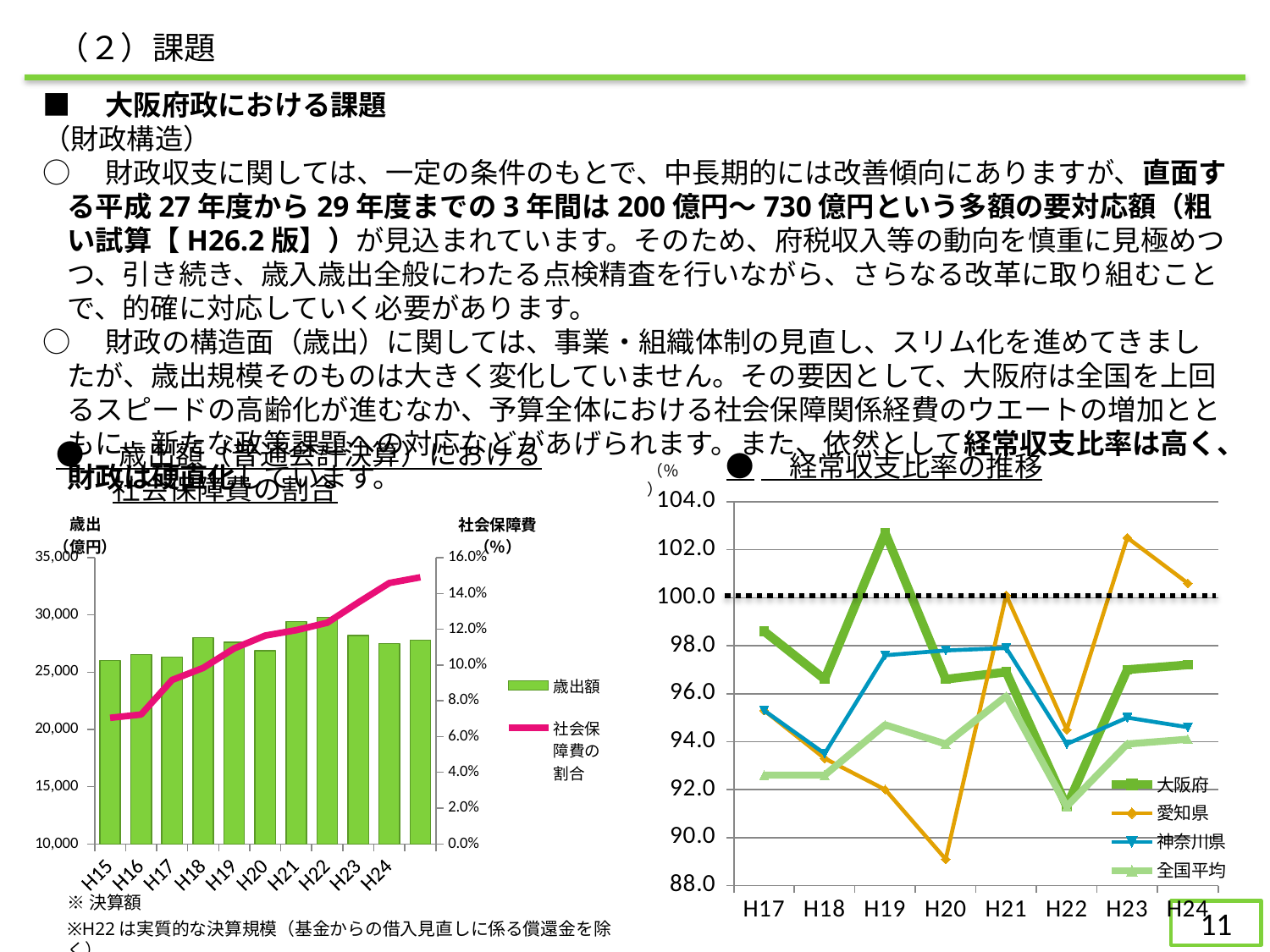
In the right chart (経常収支比率の推移), in which year does 大阪府 reach its highest value? H19 In the left chart (歳出額と社会保障費の割合), how many fiscal years are shown on the x axis? 10 In the left chart (歳出額と社会保障費の割合), does the 社会保障費の割合 line rise or fall from H15 to H24? rise In the left chart (歳出額と社会保障費の割合), how many series does the legend list? 2 In the left chart (歳出額と社会保障費の割合), what kind of chart is used for 歳出額? bar chart In the left chart (歳出額と社会保障費の割合), is the 社会保障費の割合 value for H24 greater or less than 14.0%? greater In the left chart (歳出額と社会保障費の割合), is the 歳出額 bar for H22 greater or less than 25,000? greater In the left chart (歳出額と社会保障費の割合), is the 社会保障費の割合 value for H15 greater or less than 8.0%? less In the right chart (経常収支比率の推移), which is larger in H20, 大阪府 or 愛知県? 大阪府 In the right chart (経常収支比率の推移), how many series does the legend list? 4 In the right chart (経常収支比率の推移), in which year does 愛知県 reach its lowest value? H20 In the right chart (経常収支比率の推移), how many fiscal years are shown on the x axis? 8